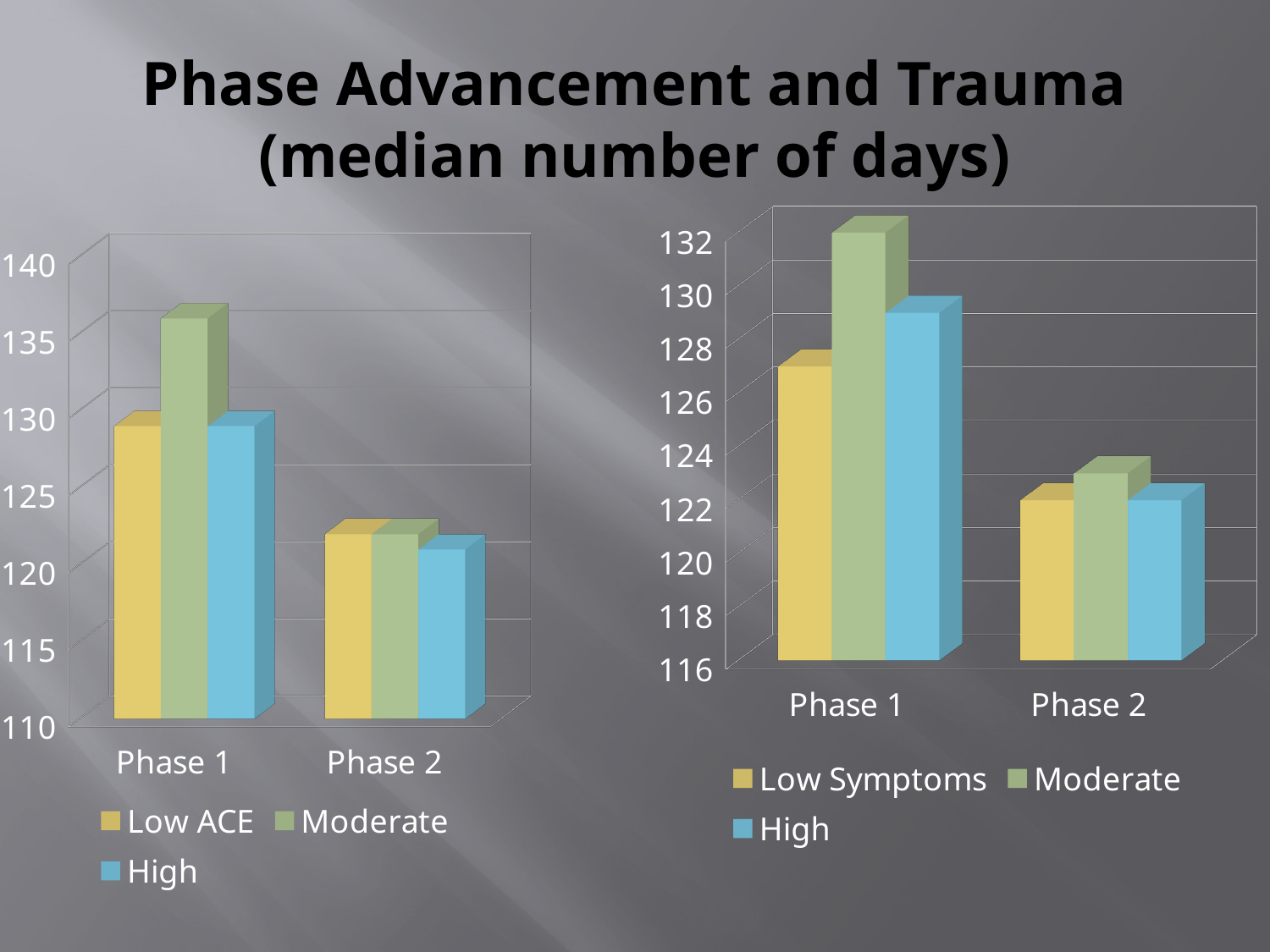
In the right chart, is the Moderate value for Phase 1 greater or less than 130? greater In the right chart, do the High values rise or fall from Phase 1 to Phase 2? fall In the left chart, is the Moderate value for Phase 1 greater or less than 130? greater In the right chart, which series has the highest value for Phase 1? Moderate In the left chart, which series has the highest value for Phase 1? Moderate How many categories are shown on the x axis of the left chart? 2 In the right chart, which series has the lowest value for Phase 1? Low Symptoms In the right chart, is the Low Symptoms value for Phase 2 greater or less than 124? less How many series does the legend of the right chart list? 3 In the left chart, is the Moderate value larger for Phase 1 or Phase 2? Phase 1 What kind of chart is the left chart on the slide? bar chart